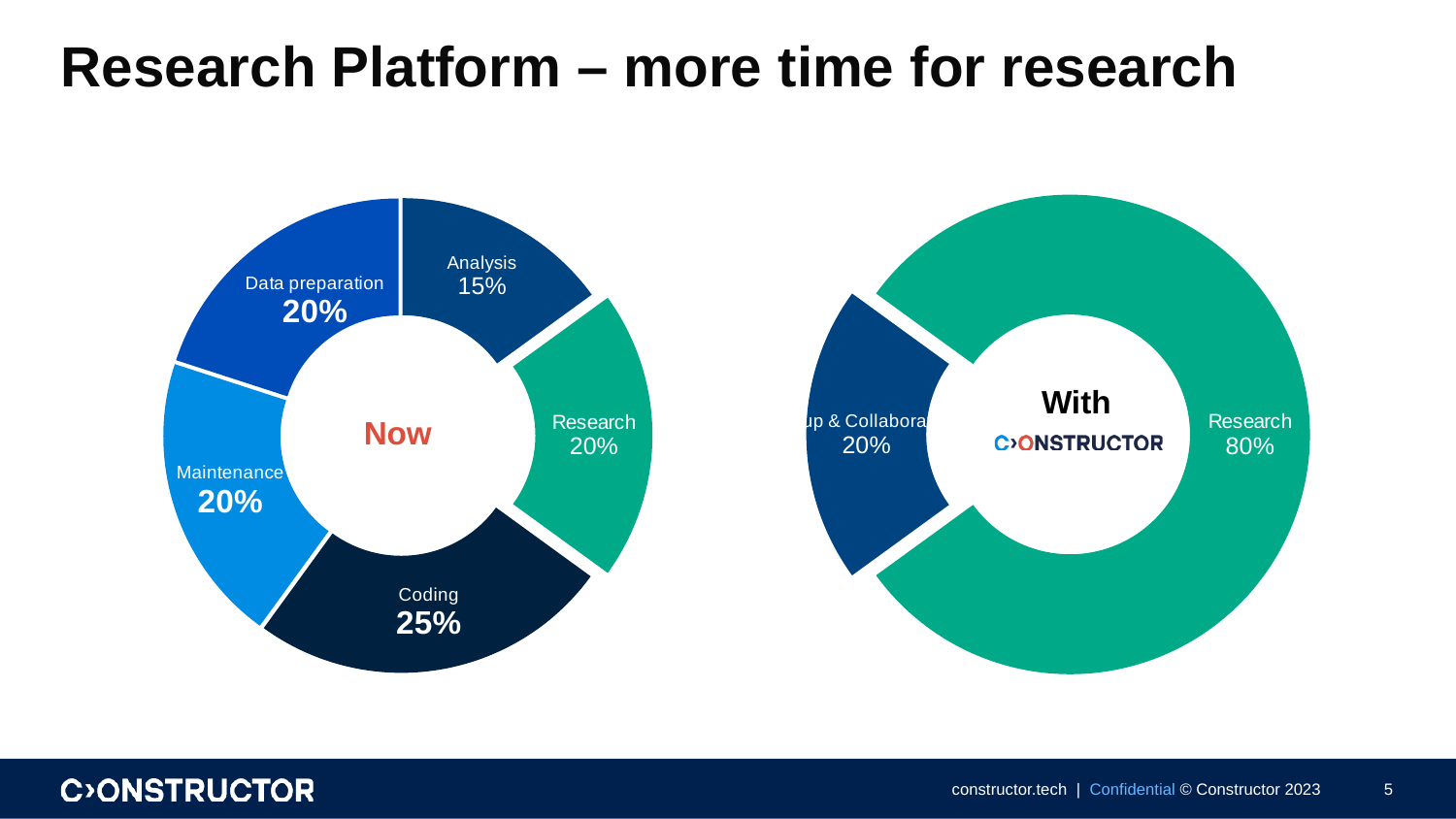
In the left 'Now' chart, which category has the largest share? Coding In the left 'Now' chart, what share of time is spent on Research? 20% In the left 'Now' chart, which category has the smallest share? Analysis What type of chart is used on this slide? Donut (pie) chart In the left 'Now' chart, what share of time is spent on Analysis? 15% In the left 'Now' chart, what is the difference between the Coding share and the Analysis share? 10% In the left 'Now' chart, what share of time is spent on Data preparation? 20% What is the difference between the Research share in the right 'With Constructor' chart and the Research share in the left 'Now' chart? 60% In the right 'With Constructor' chart, what share of time is spent on Research? 80% How many categories are shown in the left 'Now' chart? 5 In the left 'Now' chart, which is larger: the share for Coding or the share for Maintenance? Coding In the left 'Now' chart, what share of time is spent on Coding? 25%